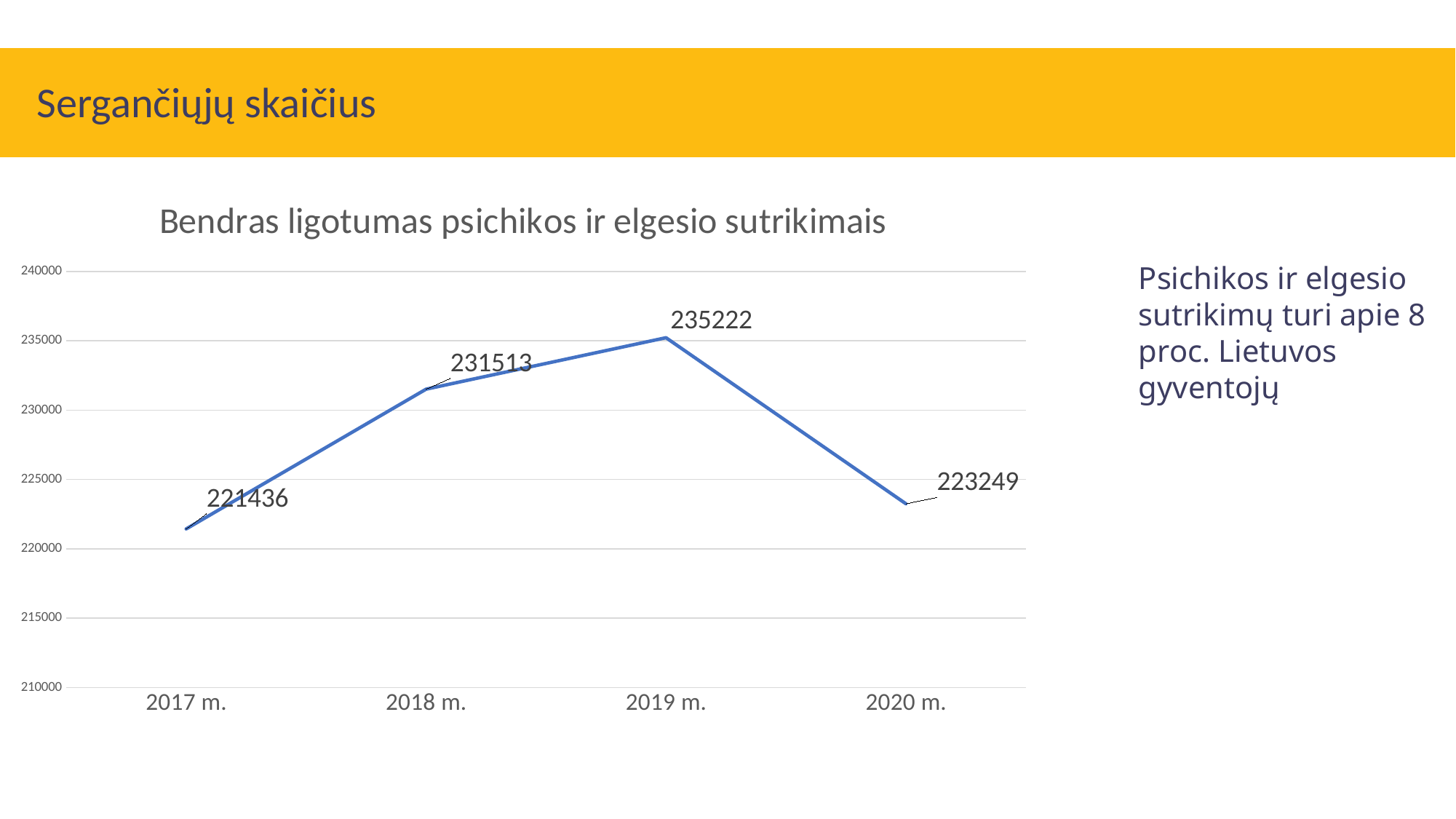
Is the value for 2018 m. greater or less than 230000? greater Which is larger, the value for 2018 m. or the value for 2020 m.? 2018 m. Which year has the lowest value? 2017 m. What is the value for 2019 m.? 235222 Which year has the highest value? 2019 m. What is the difference between the values for 2019 m. and 2018 m.? 3709 What kind of chart is shown on the slide? line chart How many years are plotted on the chart? 4 What is the value for 2017 m.? 221436 What is the title of the chart? Bendras ligotumas psichikos ir elgesio sutrikimais What is the difference between the values for 2019 m. and 2020 m.? 11973 What is the value for 2020 m.? 223249